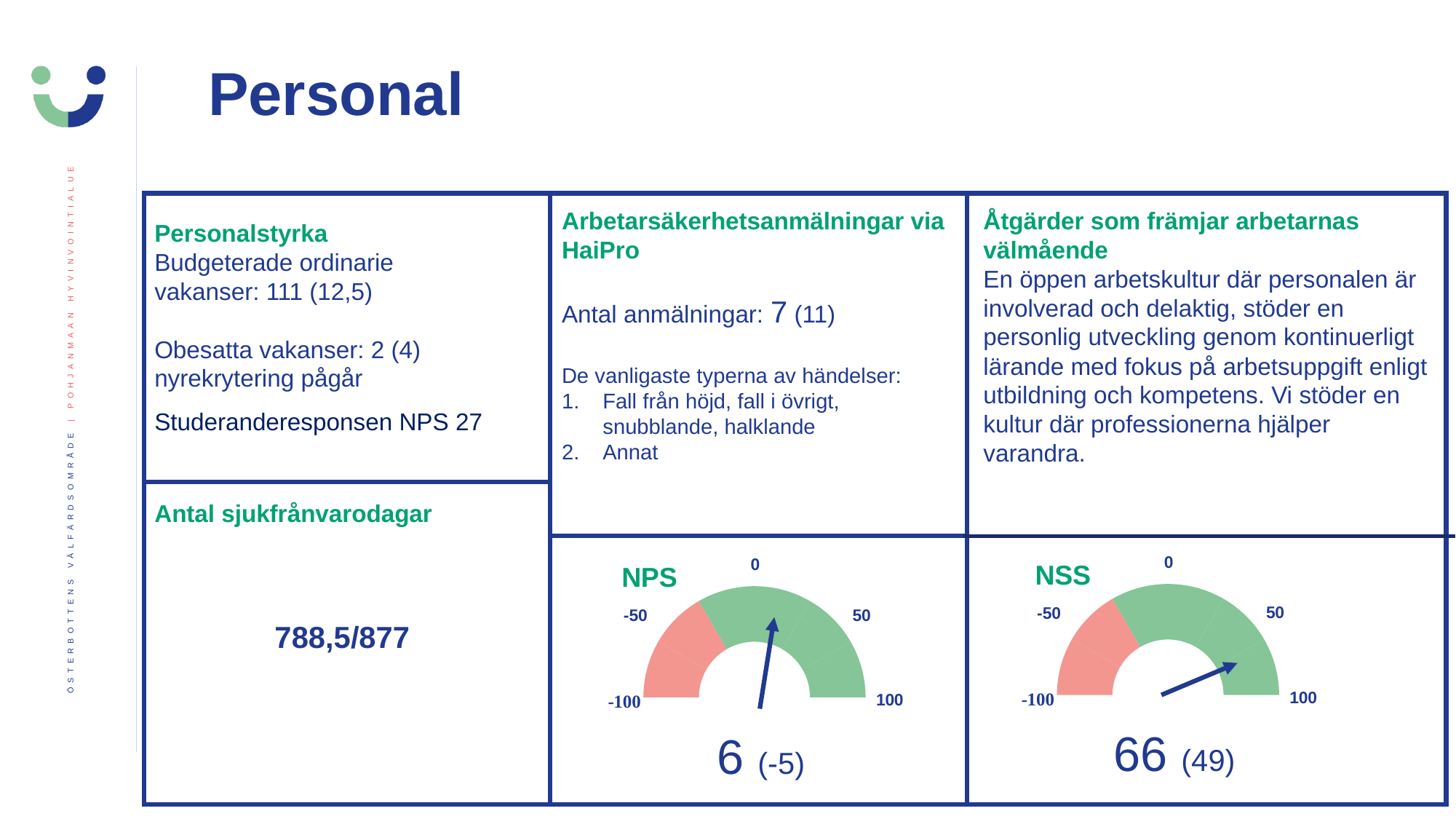
What is the previous value shown in parentheses below the NPS gauge? -5 Which gauge shows the higher current value, NPS or NSS? NSS Is the value on the NPS gauge greater or less than 50? less What is the previous value shown in parentheses below the NSS gauge? 49 What kind of chart is used to display NPS and NSS? Gauge chart What is the maximum value marked on the NPS gauge scale? 100 What value does the NSS gauge chart show? 66 What is the difference between the NSS value and the NPS value? 60 Is the value on the NSS gauge greater or less than 50? greater What value does the NPS gauge chart show? 6 What is the minimum value marked on the NSS gauge scale? -100 By how much did the NSS value change from the previous value in parentheses to the current value? 17